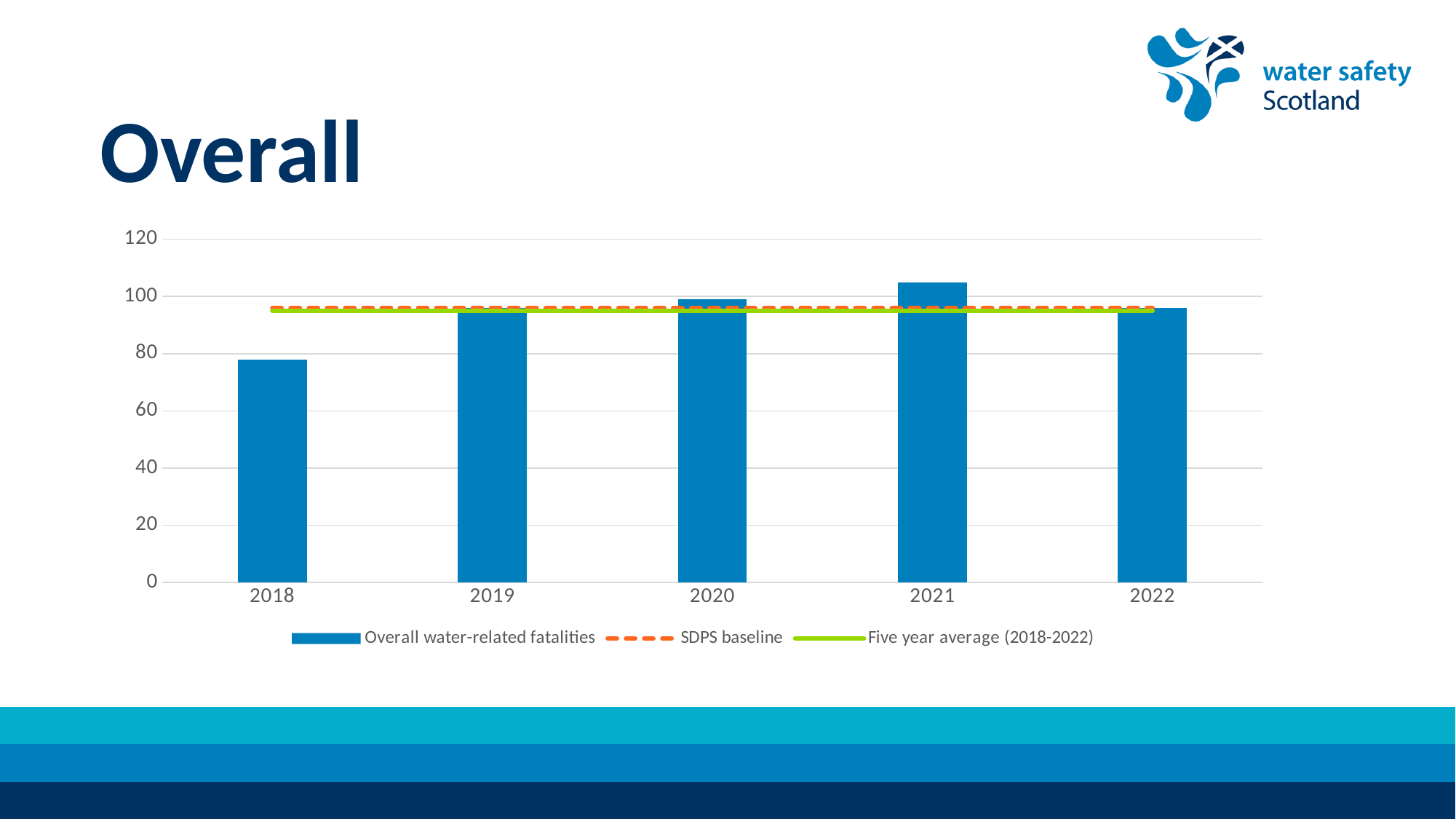
Do overall water-related fatalities rise or fall from 2018 to 2021? rise How many series does the chart legend list? 3 Which year has the highest number of overall water-related fatalities? 2021 How many years are shown on the x axis of the chart? 5 What is the title of the slide? Overall Which year has the lowest number of overall water-related fatalities? 2018 Is the value for overall water-related fatalities in 2019 greater or less than 100? less Which legend entry is shown as an orange dashed line? SDPS baseline Which year has more overall water-related fatalities, 2018 or 2021? 2021 Is the value for overall water-related fatalities in 2018 greater or less than 80? less What kind of chart is shown on the slide? bar chart Is the value for overall water-related fatalities in 2021 greater or less than 100? greater